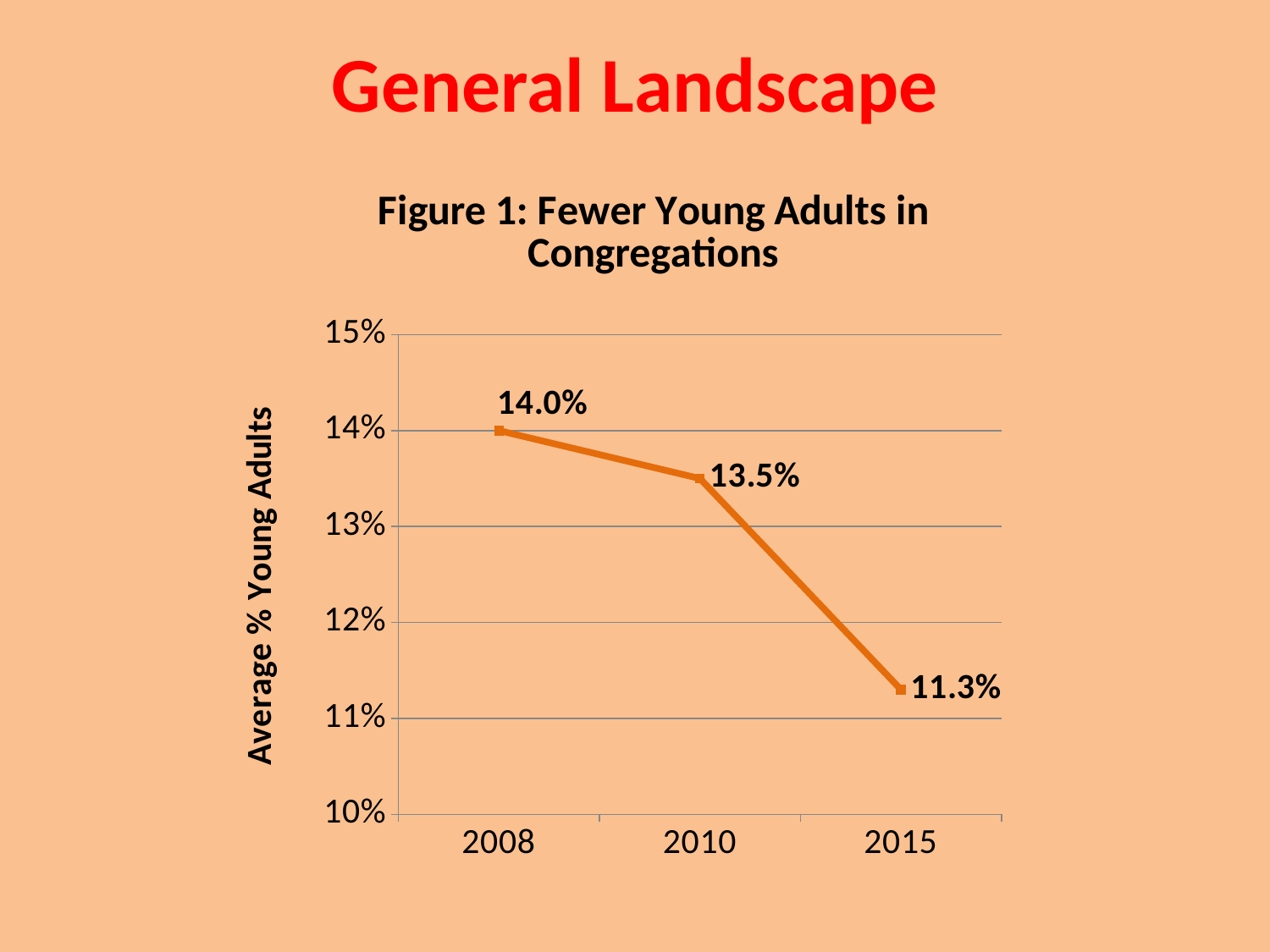
Is the value for 2015 greater or less than 12%? less How many data points are plotted on the chart? 3 What kind of chart is shown on the slide? line chart Which year has the lowest average % of young adults? 2015 Which is larger, the value for 2010 or the value for 2015? 2010 What is the average % of young adults in 2010? 13.5% Which year has the highest average % of young adults? 2008 What is the average % of young adults in 2015? 11.3% What is the average % of young adults in 2008? 14.0% Do the values rise or fall from 2008 to 2015? fall What is the difference between the 2008 and 2015 values? 2.7% What is the difference between the 2010 and 2015 values? 2.2%